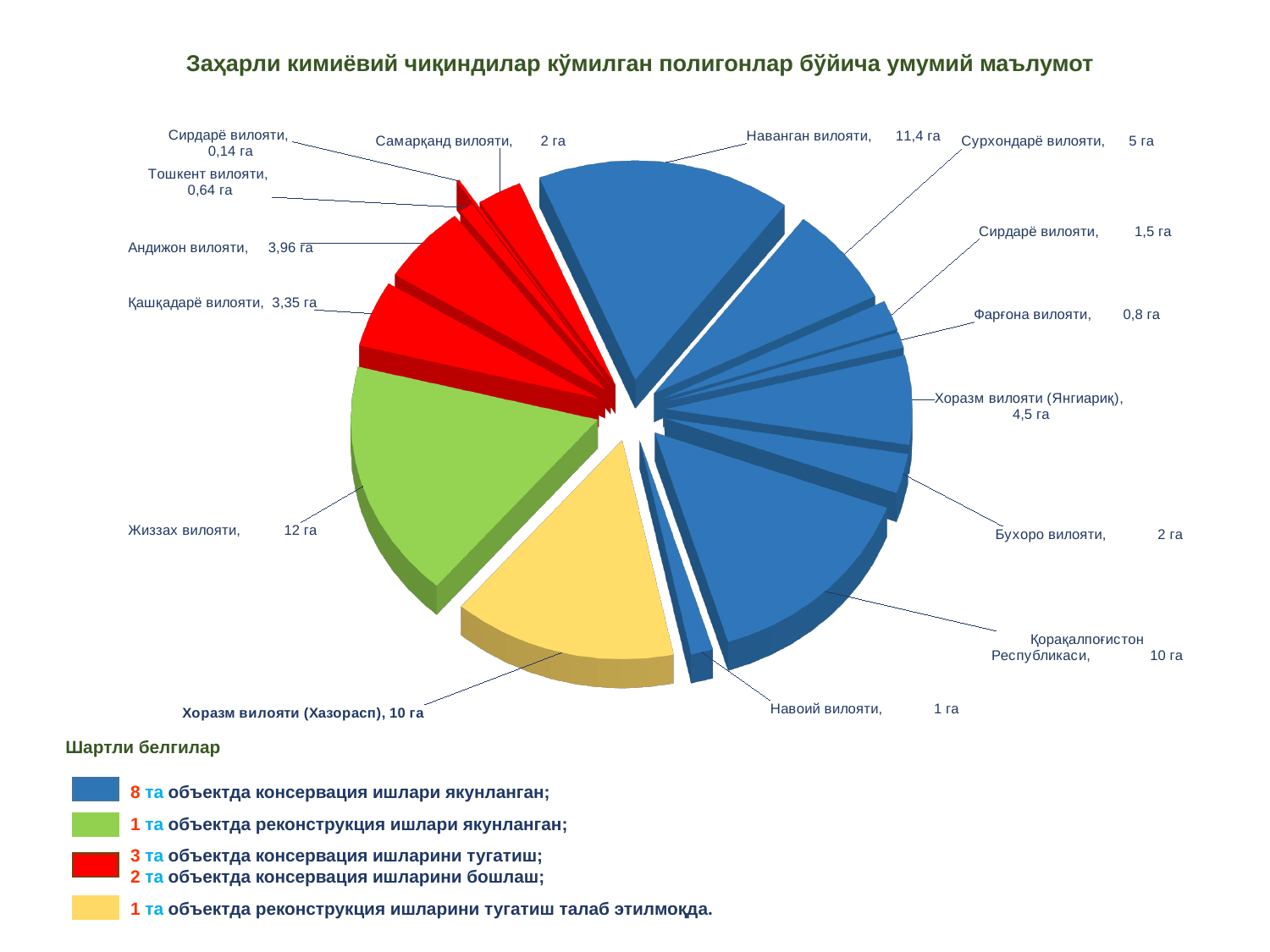
Which is larger, the value for Сурхондарё вилояти or for Хоразм вилояти (Янгиариқ)? Сурхондарё вилояти What is the smallest value shown on the pie chart? 0,14 га What is the difference between the values for Қорақалпоғистон Республикаси and Навоий вилояти? 9 га How many slices does the pie chart have? 15 Which region has the largest slice of the pie? Жиззах вилояти What is the value for Наванган вилояти? 11,4 га What is the value for Андижон вилояти? 3,96 га What kind of chart is shown on the slide? pie chart What is the value for Жиззах вилояти? 12 га What colour is the slice for Жиззах вилояти? green What is the difference between the values for Жиззах вилояти and Наванган вилояти? 0,6 га What is the value for Хоразм вилояти (Янгиариқ)? 4,5 га